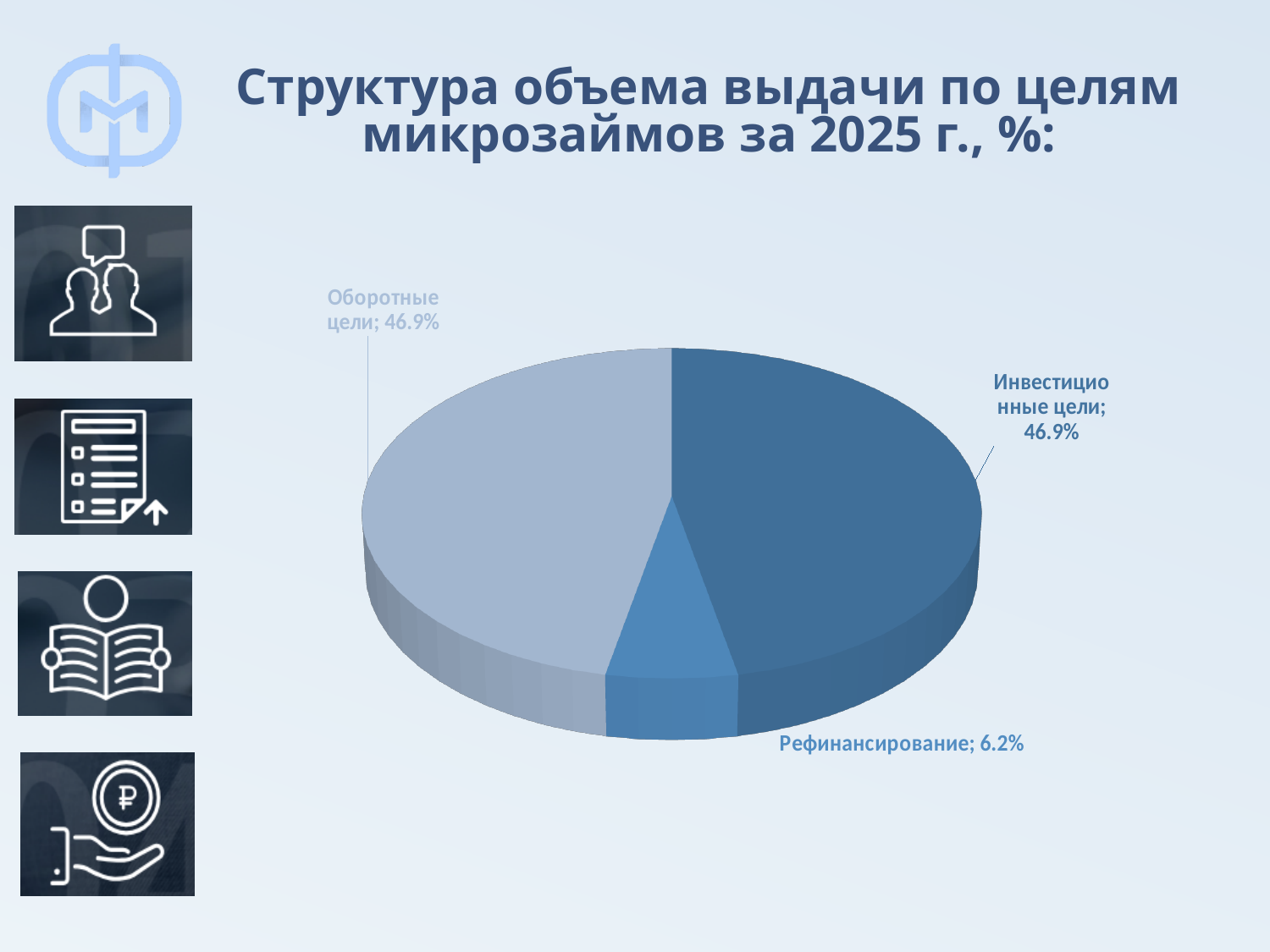
What share of the pie does Рефинансирование account for? 6.2% Which is larger: the share for Оборотные цели or the share for Рефинансирование? Оборотные цели What is the value shown for Инвестиционные цели? 46.9% What is the title of the chart on the slide? Структура объема выдачи по целям микрозаймов за 2025 г., %: Do the shares for Оборотные цели and Инвестиционные цели have the same value? Yes What kind of chart is shown on the slide? Pie chart How many categories (slices) does the pie chart show? 3 What is the difference between the share for Инвестиционные цели and the share for Рефинансирование? 40.7% What is the value shown for Оборотные цели? 46.9% What is the difference between the share for Оборотные цели and the share for Рефинансирование? 40.7% Which is larger: the share for Инвестиционные цели or the share for Рефинансирование? Инвестиционные цели Which category has the smallest share of the pie? Рефинансирование